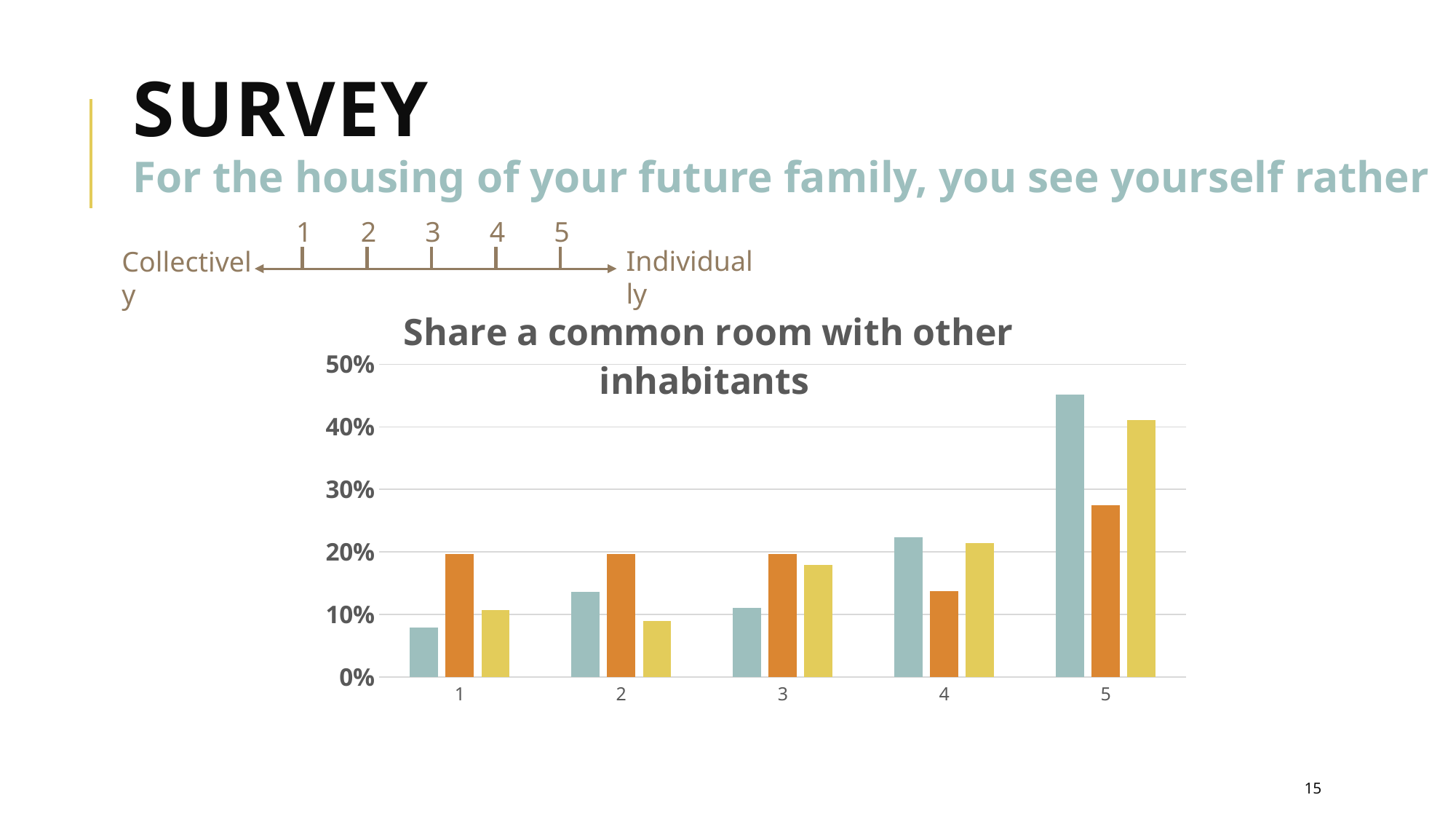
Is the value of the teal bar for category 5 greater or less than 40%? greater Is the value of the orange bar for category 5 greater or less than 20%? greater Is the value of the orange bar for category 4 greater or less than 20%? less For which category is the teal bar the tallest? 5 What kind of chart is shown on the slide? bar chart For which category is the orange bar the shortest? 4 From category 3 to category 5, do the teal bars rise or fall? rise How many categories are shown on the x axis of the chart? 5 How many series (bars per category) does the chart show? 3 What is the title of the chart? Share a common room with other inhabitants For category 1, which bar is taller, the teal bar or the orange bar? orange